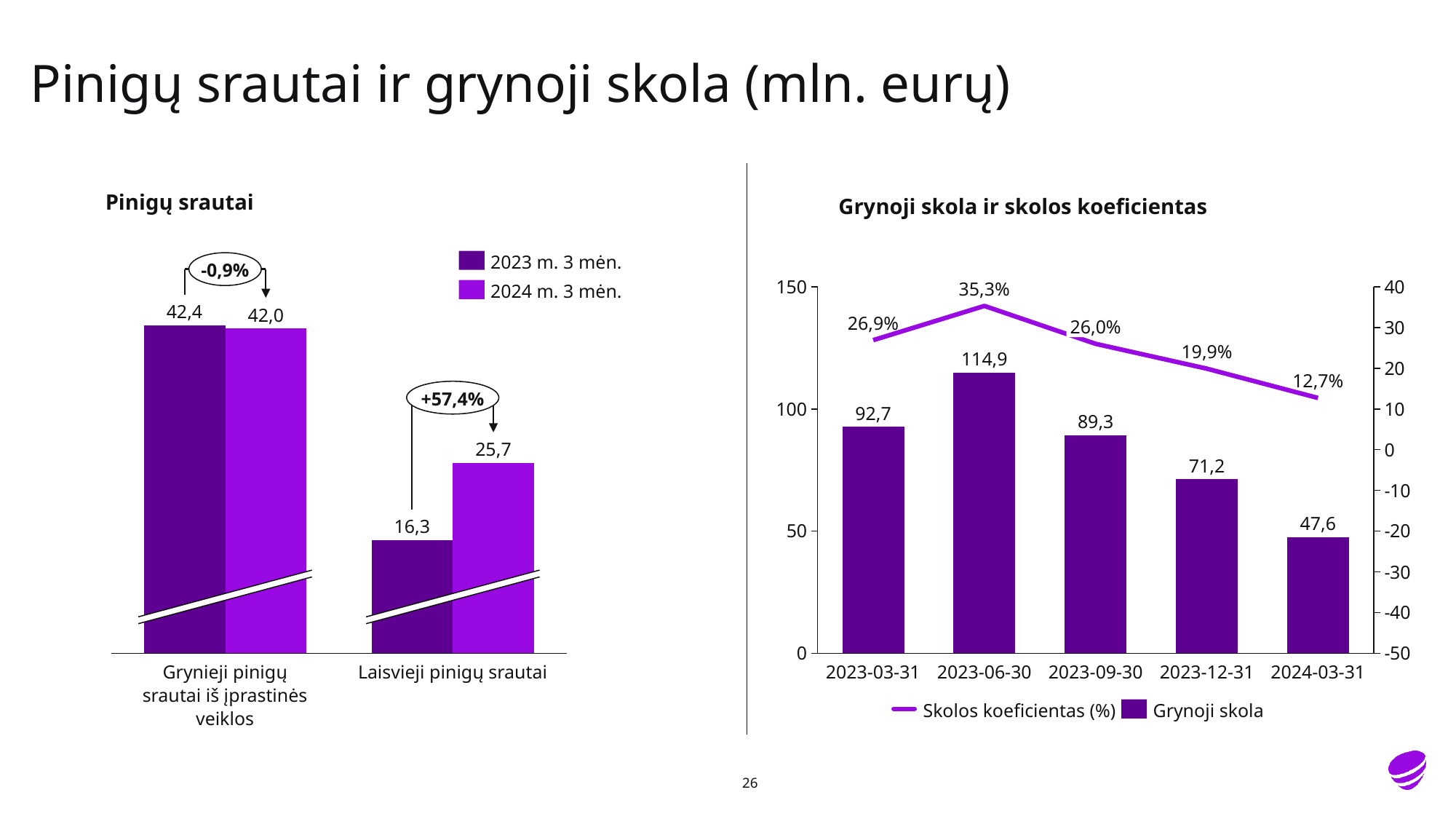
In the 'Grynoji skola ir skolos koeficientas' chart, what is the Skolos koeficientas (%) value for 2024-03-31? 12,7% In the 'Grynoji skola ir skolos koeficientas' chart, does Grynoji skola rise or fall from 2023-06-30 to 2024-03-31? fall In the 'Grynoji skola ir skolos koeficientas' chart, which date has the lowest Grynoji skola? 2024-03-31 In the 'Grynoji skola ir skolos koeficientas' chart, how many dates are shown on the x axis? 5 In the 'Pinigų srautai' chart, what is the difference between the 2024 m. 3 mėn. and 2023 m. 3 mėn. values for Laisvieji pinigų srautai? 9,4 In the 'Grynoji skola ir skolos koeficientas' chart, what is the Grynoji skola value for 2023-06-30? 114,9 In the 'Pinigų srautai' chart, what is the value for Laisvieji pinigų srautai in 2024 m. 3 mėn.? 25,7 In the 'Pinigų srautai' chart, how many series does the legend list? 2 In the 'Pinigų srautai' chart, what is the value for Grynieji pinigų srautai iš įprastinės veiklos in 2023 m. 3 mėn.? 42,4 In the 'Grynoji skola ir skolos koeficientas' chart, which date has the highest Skolos koeficientas (%)? 2023-06-30 In the 'Grynoji skola ir skolos koeficientas' chart, what is the difference in Grynoji skola between 2023-03-31 and 2024-03-31? 45,1 In the 'Pinigų srautai' chart, what percentage change is shown for Grynieji pinigų srautai iš įprastinės veiklos? -0,9%